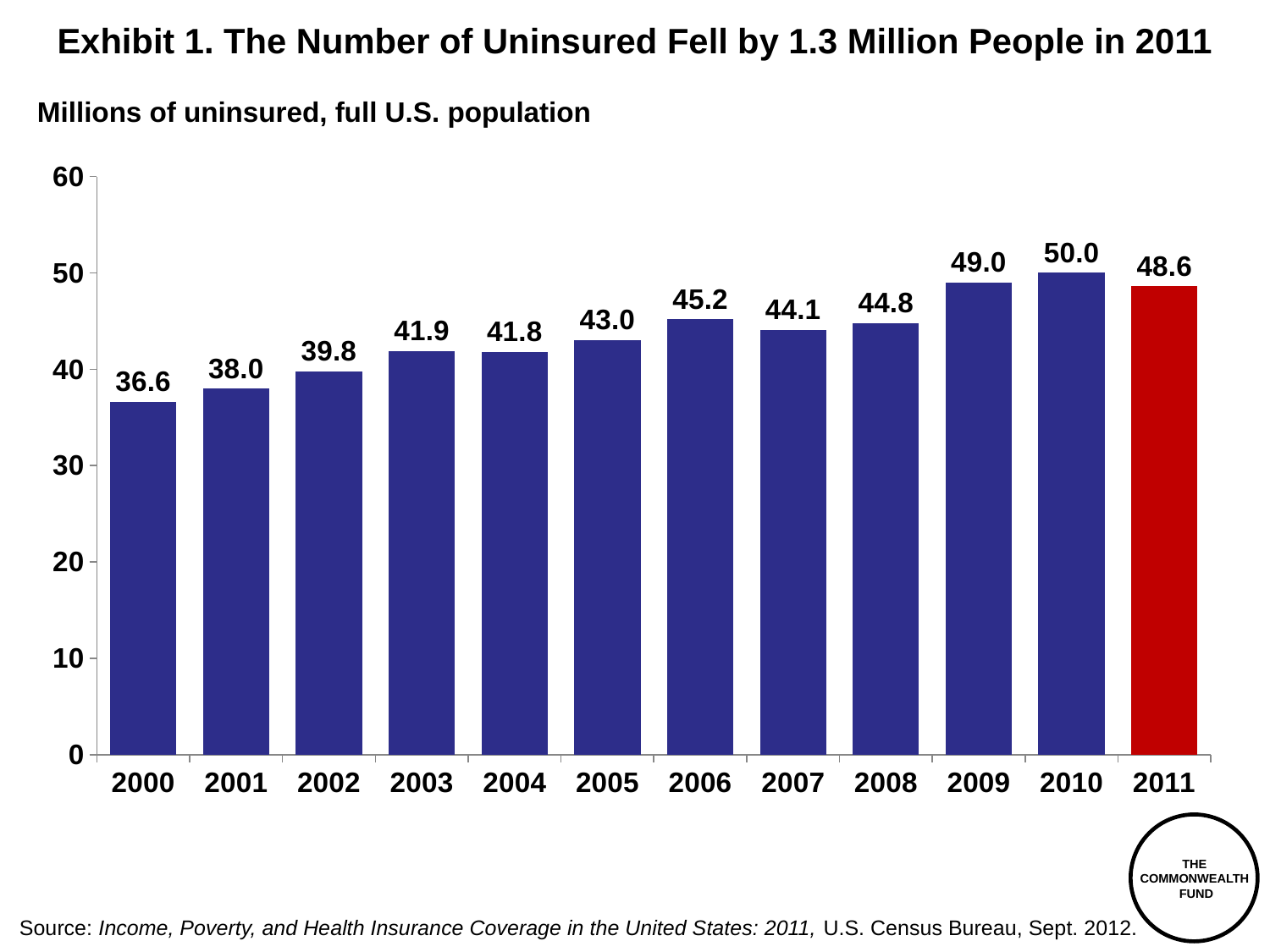
What is the overall trend in the number of uninsured from 2000 to 2010? rising What kind of chart is shown on the slide? bar chart What was the number of uninsured (in millions) in 2005? 43.0 Which bar is coloured red rather than blue? 2011 Which year has the lowest number of uninsured? 2000 What is the difference between the values for 2009 and 2000? 12.4 By how much did the number of uninsured change from 2010 to 2011? 1.4 Which year has the highest number of uninsured? 2010 How many years are shown on the chart? 12 Which year has a larger value, 2006 or 2007? 2006 What value is shown for 2011? 48.6 Is the value for 2002 greater or less than 40? less